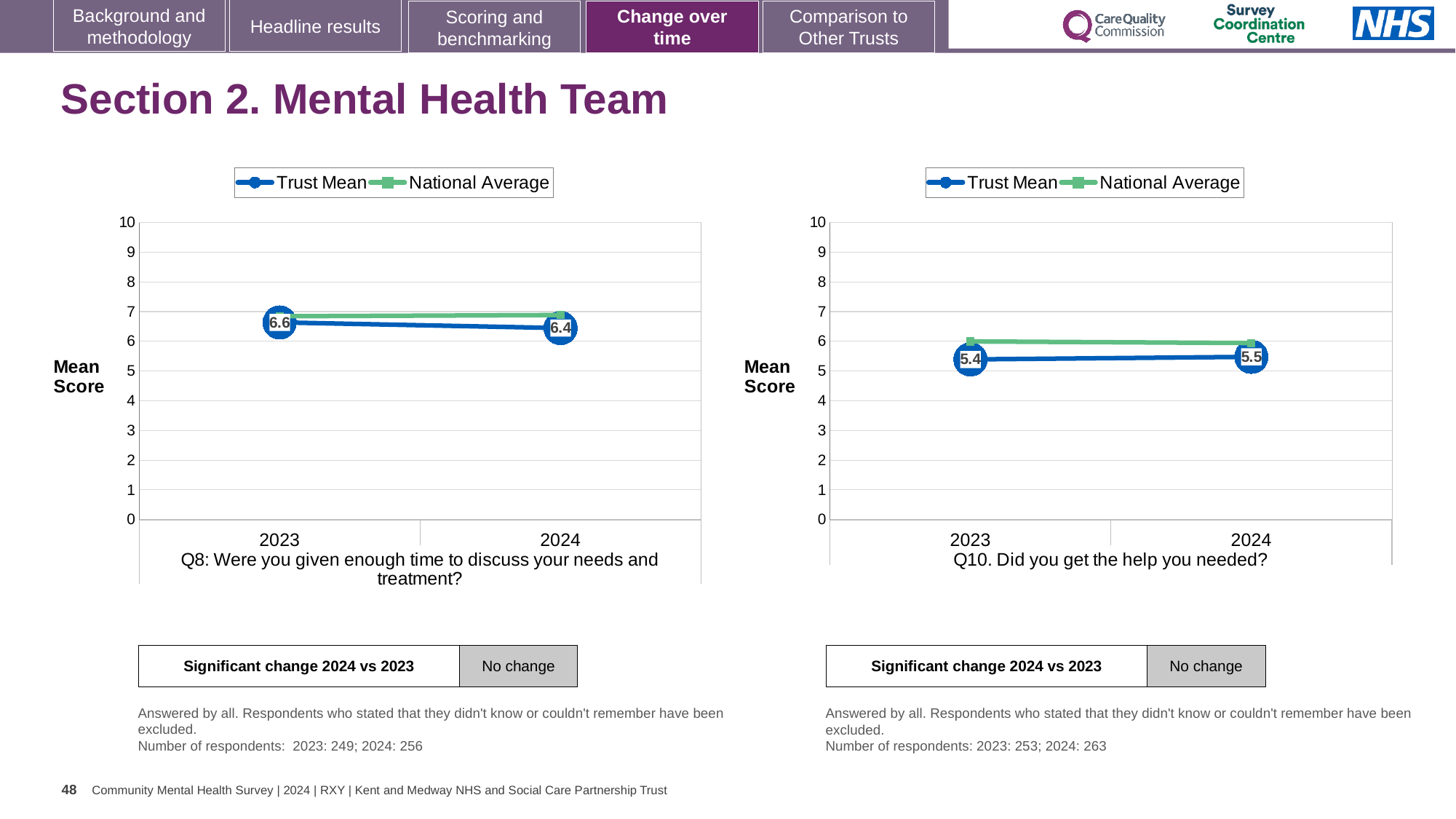
In the Q10 chart (right), is the National Average for 2024 greater or less than 7? less In the Q8 chart (left), what is the Trust Mean score for 2023? 6.6 In the Q10 chart (right), what is the Trust Mean score for 2023? 5.4 In the Q8 chart (left), what is the Trust Mean score for 2024? 6.4 In the Q10 chart (right), does the Trust Mean rise or fall from 2023 to 2024? rise In the Q10 chart (right), which is higher in 2023, the Trust Mean or the National Average? National Average What kind of chart is the Q10 chart (right)? line chart In the Q8 chart (left), by how much did the Trust Mean change from 2023 to 2024? 0.2 In the Q8 chart (left), does the Trust Mean rise or fall from 2023 to 2024? fall How many series does the legend of the Q8 chart (left) list? 2 In the Q10 chart (right), what is the Trust Mean score for 2024? 5.5 In the Q8 chart (left), is the National Average for 2023 greater or less than 6? greater